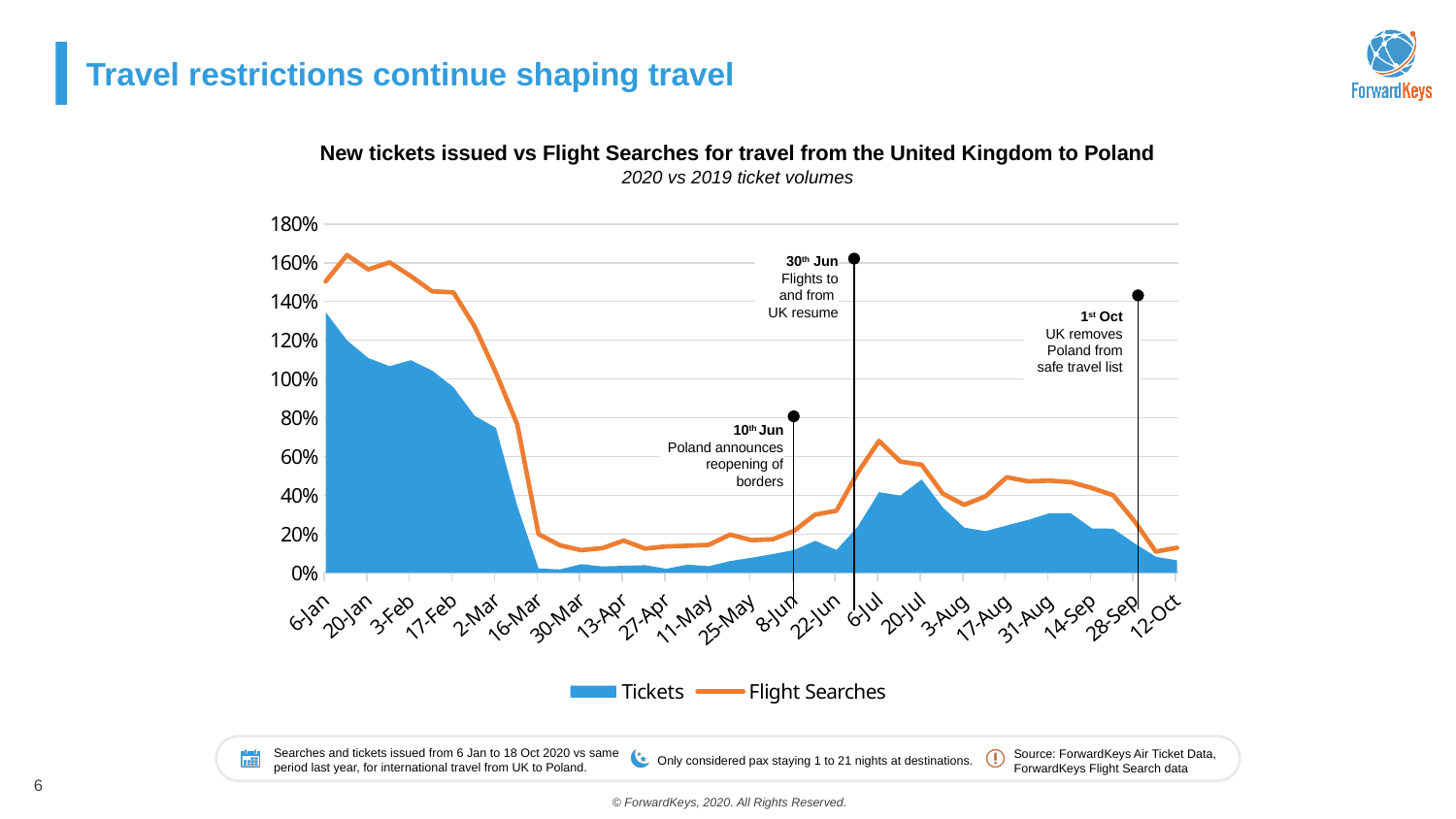
What kind of chart is this? An area chart (Tickets) combined with a line chart (Flight Searches) How many series does the legend list? 2 Which series has the higher value at 6-Jan, Tickets or Flight Searches? Flight Searches Do Tickets rise or fall between 6-Jan and 16-Mar? fall Is the Flight Searches value at 12-Oct greater or less than 20%? less Do Flight Searches rise or fall between 8-Jun and 6-Jul? rise Which event does the annotation dated 1st Oct describe? UK removes Poland from safe travel list What colour is used for the Tickets series? Blue Is the Tickets value at 6-Jan greater or less than 120%? greater Is the Flight Searches value at 6-Jan greater or less than 140%? greater